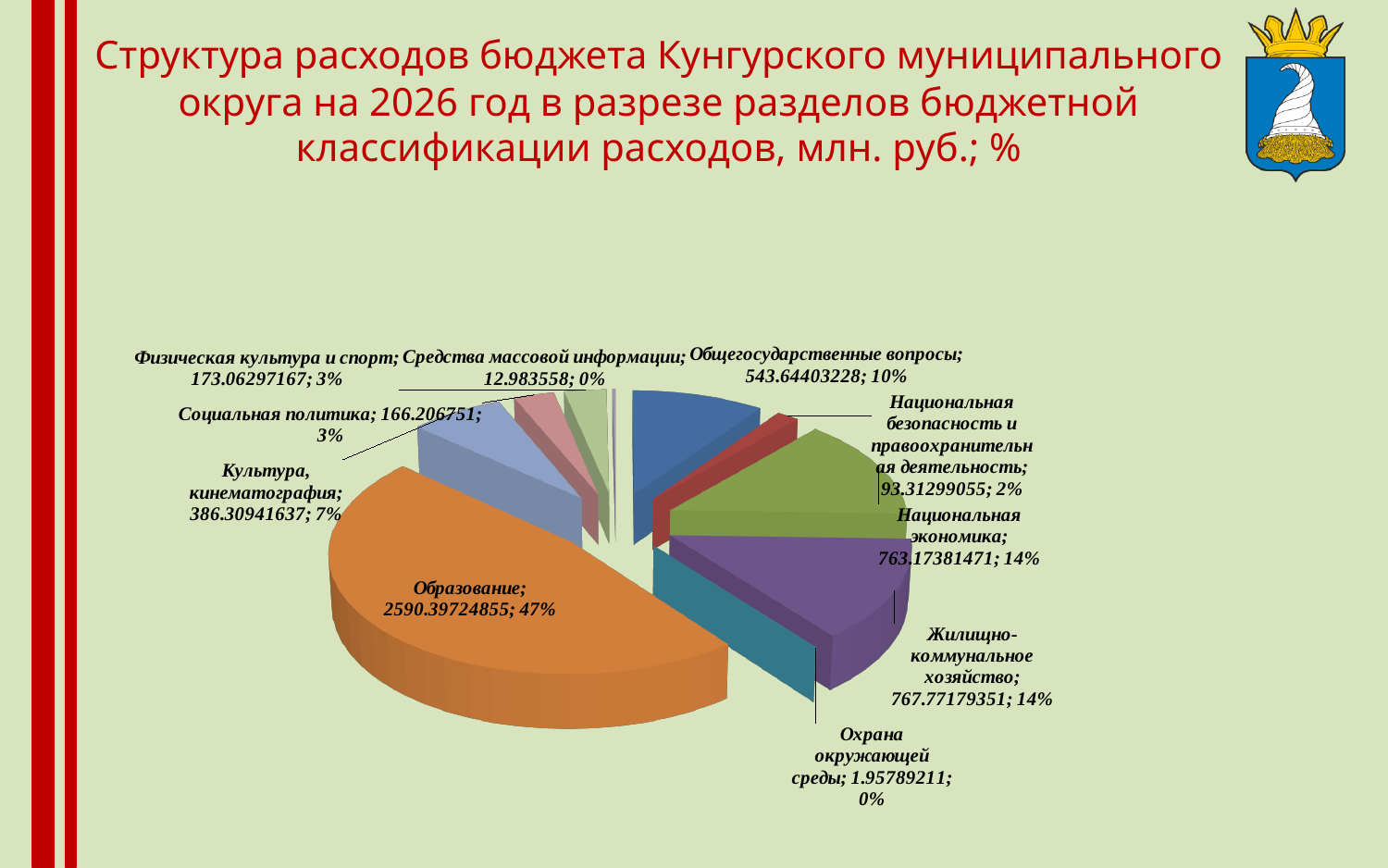
What is the value for Общегосударственные вопросы? 543.64403228 What is the difference between the values for Жилищно-коммунальное хозяйство and Национальная экономика? 4.5979788 What is the value for Культура, кинематография? 386.30941637 What type of chart is shown on the slide? Pie chart Which category has the largest share of the pie? Образование Which is larger: Жилищно-коммунальное хозяйство or Национальная экономика? Жилищно-коммунальное хозяйство What share of the pie does Образование represent? 47% Which category has the smallest value in the pie chart? Охрана окружающей среды What is the value for Образование? 2590.39724855 How many categories (slices) does the pie chart have? 10 What share of the pie does Национальная экономика represent? 14% What is the difference between the values for Физическая культура и спорт and Социальная политика? 6.85622067